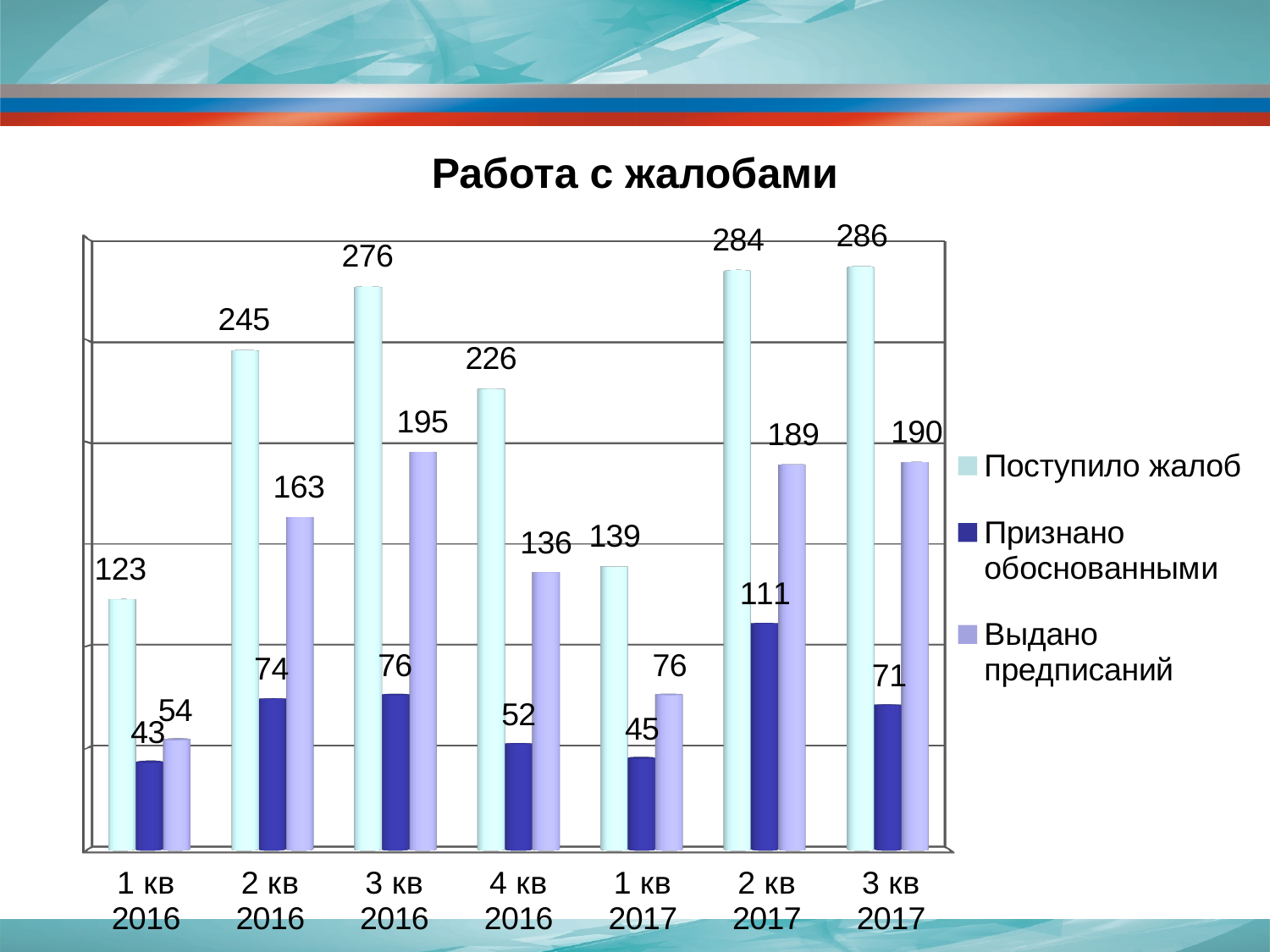
What is the title of the chart? Работа с жалобами In which quarter is Поступило жалоб highest? 3 кв 2017 Does Поступило жалоб rise or fall from 1 кв 2017 to 3 кв 2017? Rise What is the difference between Поступило жалоб and Выдано предписаний in 2 кв 2016? 82 How many series does the legend list? 3 In which quarter is Признано обоснованными lowest? 1 кв 2016 What is the value of Выдано предписаний for 4 кв 2016? 136 What kind of chart is shown on the slide? Bar chart Which is larger in 1 кв 2017: Признано обоснованными or Выдано предписаний? Выдано предписаний What is the value of Признано обоснованными for 2 кв 2017? 111 How many quarters are shown on the x axis? 7 What is the value of Поступило жалоб for 3 кв 2016? 276